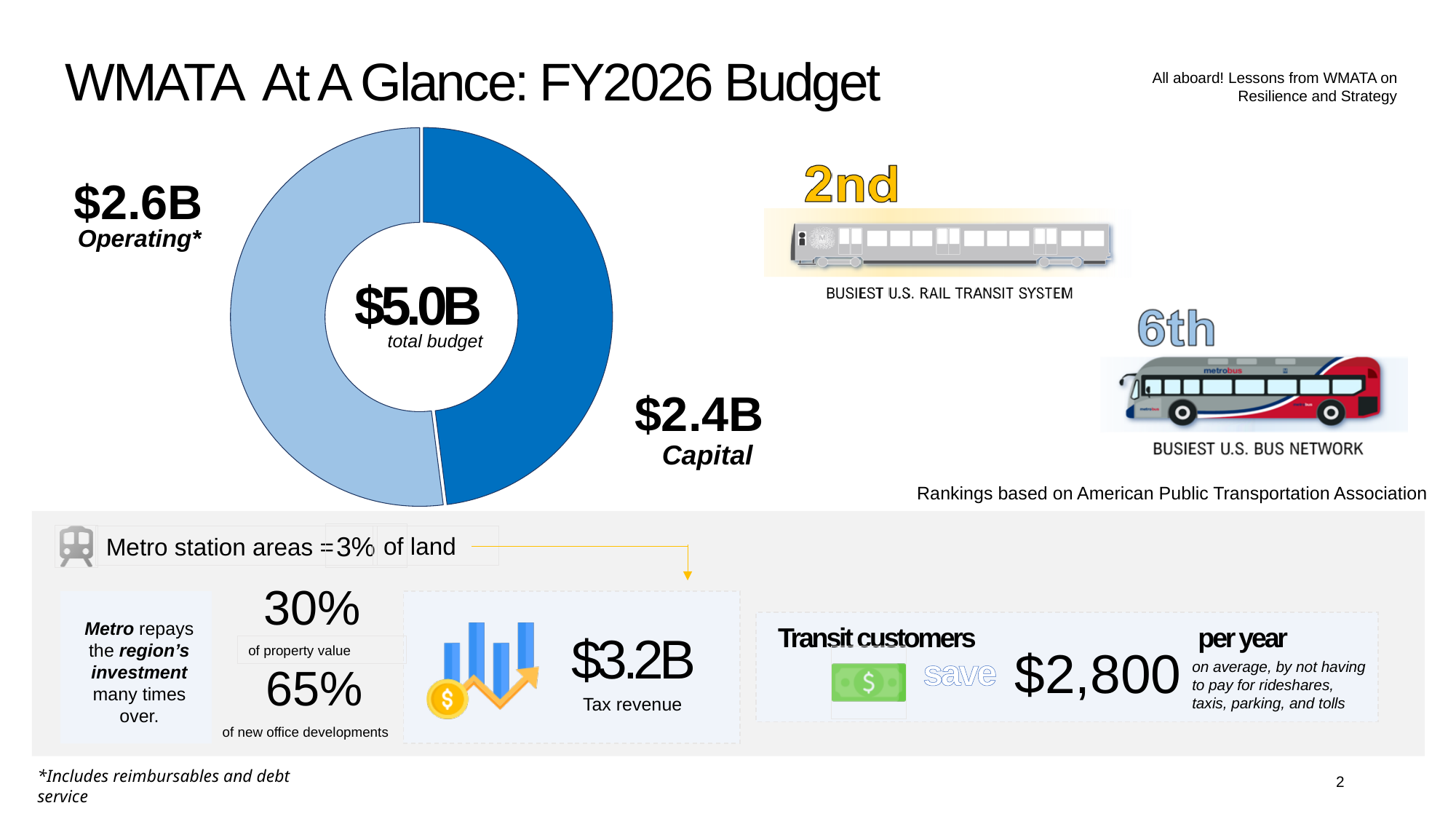
Is the Operating value larger or smaller than the Capital value in the budget chart? larger What kind of chart is used to show the FY2026 budget split? pie (donut) chart Which slice of the budget chart is drawn in the darker blue? Capital What share of the total budget does the Operating slice represent? 52% Which slice of the budget chart is the smallest? Capital What is the value of the Operating slice in the budget donut chart? $2.6B What is the difference between the Operating and Capital values in the budget chart? $0.2B Which slice of the budget chart is larger, Operating or Capital? Operating What is the value of the Capital slice in the budget donut chart? $2.4B What share of the total budget does the Capital slice represent? 48% What total budget is shown in the centre of the donut chart? $5.0B How many slices does the budget chart have? 2